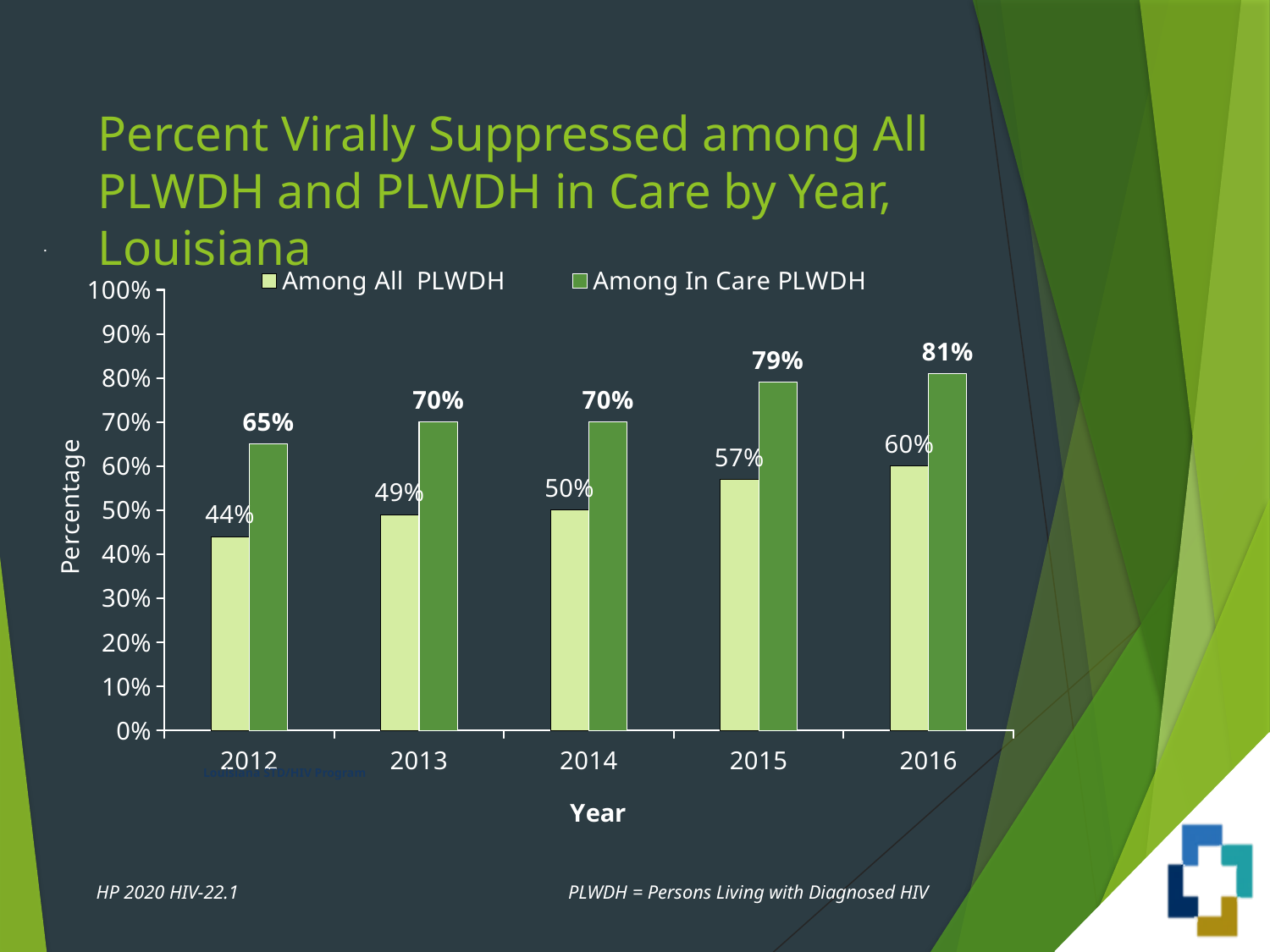
What is the value for Among All PLWDH in 2015? 57% Does the percent virally suppressed among all PLWDH rise or fall from 2012 to 2016? Rise Which year has the highest percent virally suppressed among in care PLWDH? 2016 What kind of chart is shown on the slide? Bar chart What is the difference between the Among In Care PLWDH and Among All PLWDH values in 2014? 20% Which year has the lowest percent virally suppressed among all PLWDH? 2012 What is the percent virally suppressed among all PLWDH in 2012? 44% How many years are shown on the x axis? 5 Is the value for Among In Care PLWDH in 2015 greater or less than 70%? greater Which is larger in 2013: the value for Among All PLWDH or Among In Care PLWDH? Among In Care PLWDH What is the percent virally suppressed among in care PLWDH in 2016? 81% How many series does the legend list? 2